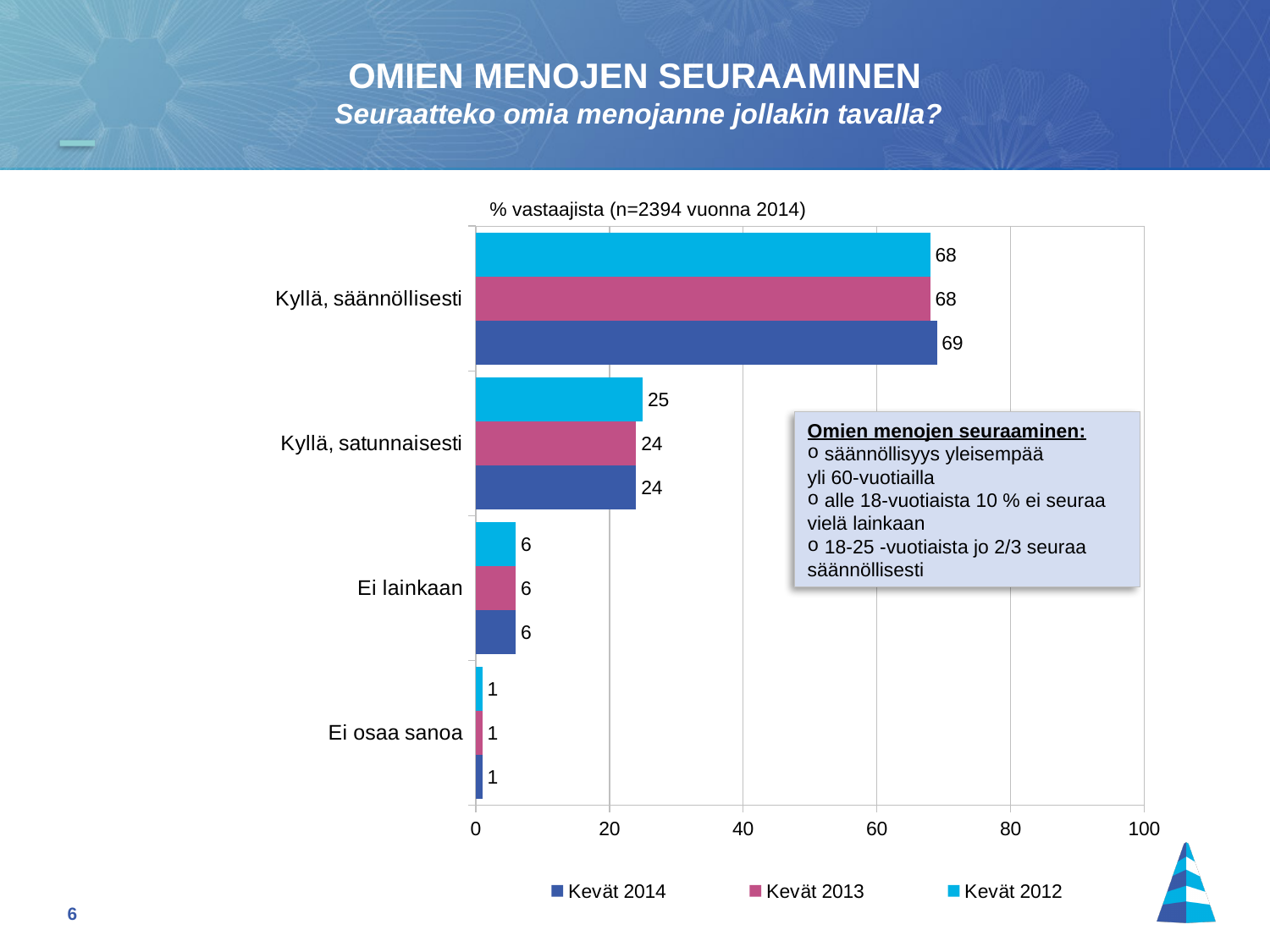
What is the difference between the Kevät 2014 values for Kyllä, säännöllisesti and Kyllä, satunnaisesti? 45 How many categories are shown on the chart? 4 What is the value for Kyllä, säännöllisesti in the Kevät 2014 series? 69 What is the value for Ei osaa sanoa in the Kevät 2014 series? 1 What is the text shown above the chart as its title? % vastaajista (n=2394 vuonna 2014) What kind of chart is shown on the slide? Bar chart Which is larger: the Kevät 2014 value for Kyllä, satunnaisesti or the Kevät 2014 value for Ei lainkaan? Kyllä, satunnaisesti What is the value for Kyllä, satunnaisesti in the Kevät 2012 series? 25 Which category has the highest value in the Kevät 2014 series? Kyllä, säännöllisesti Which category has the lowest value in the Kevät 2012 series? Ei osaa sanoa How many series does the legend list? 3 What is the value for Ei lainkaan in the Kevät 2013 series? 6